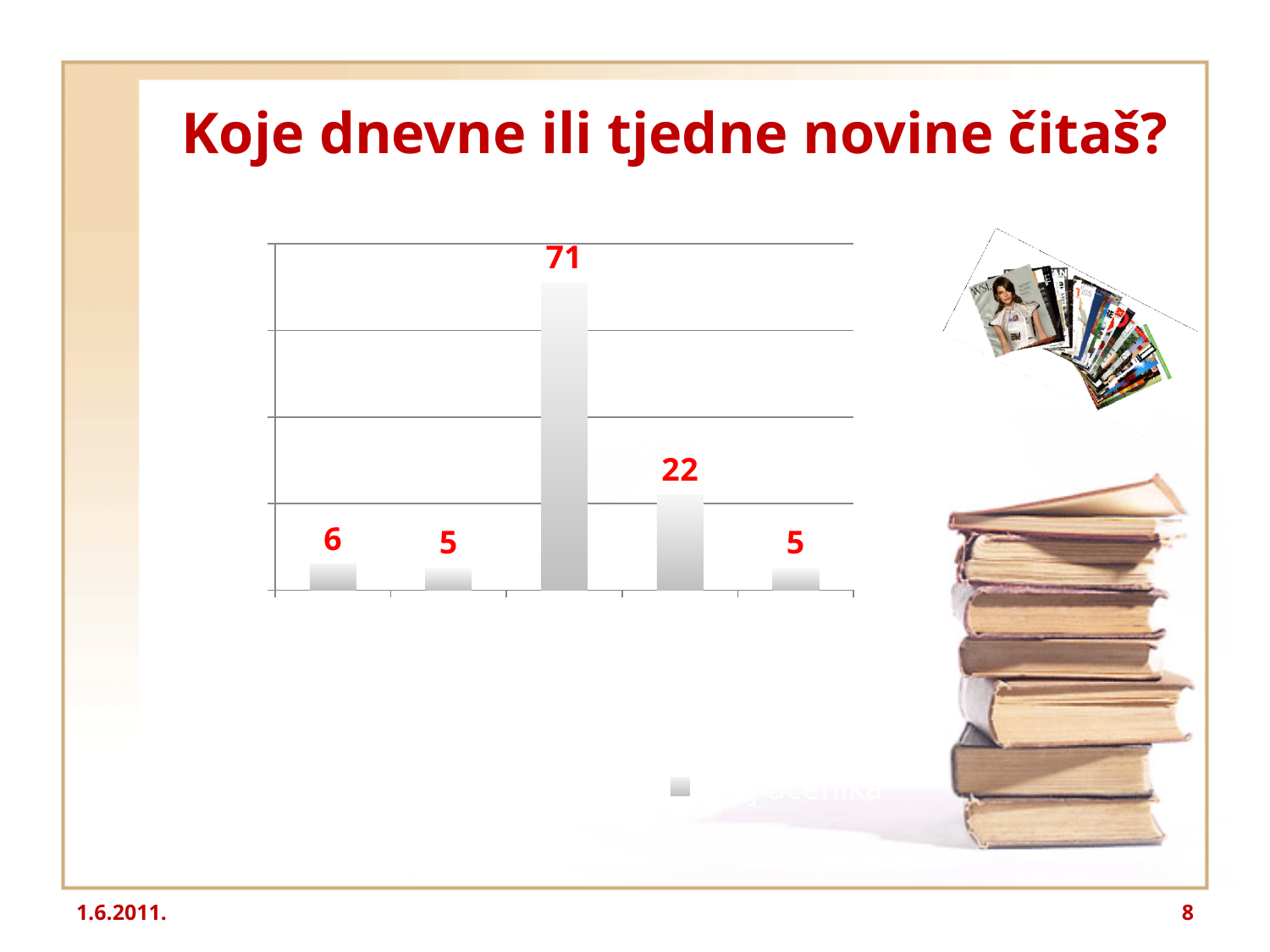
What is the value of the leftmost bar in the chart? 6 What colour are the data labels above the bars? red What is the value of the rightmost bar in the chart? 5 What is the sum of all five bar values in the chart? 109 What is the title of the slide containing the chart? Koje dnevne ili tjedne novine čitaš? How many bars are plotted in the chart? 5 What type of chart is shown on the slide? bar chart What is the difference between the leftmost bar and the second bar from the left? 1 What is the value shown on the tallest bar in the chart? 71 What is the value of the fourth bar from the left in the chart? 22 What is the difference between the tallest bar (71) and the fourth bar from the left (22)? 49 Which is larger: the leftmost bar or the second bar from the left? the leftmost bar